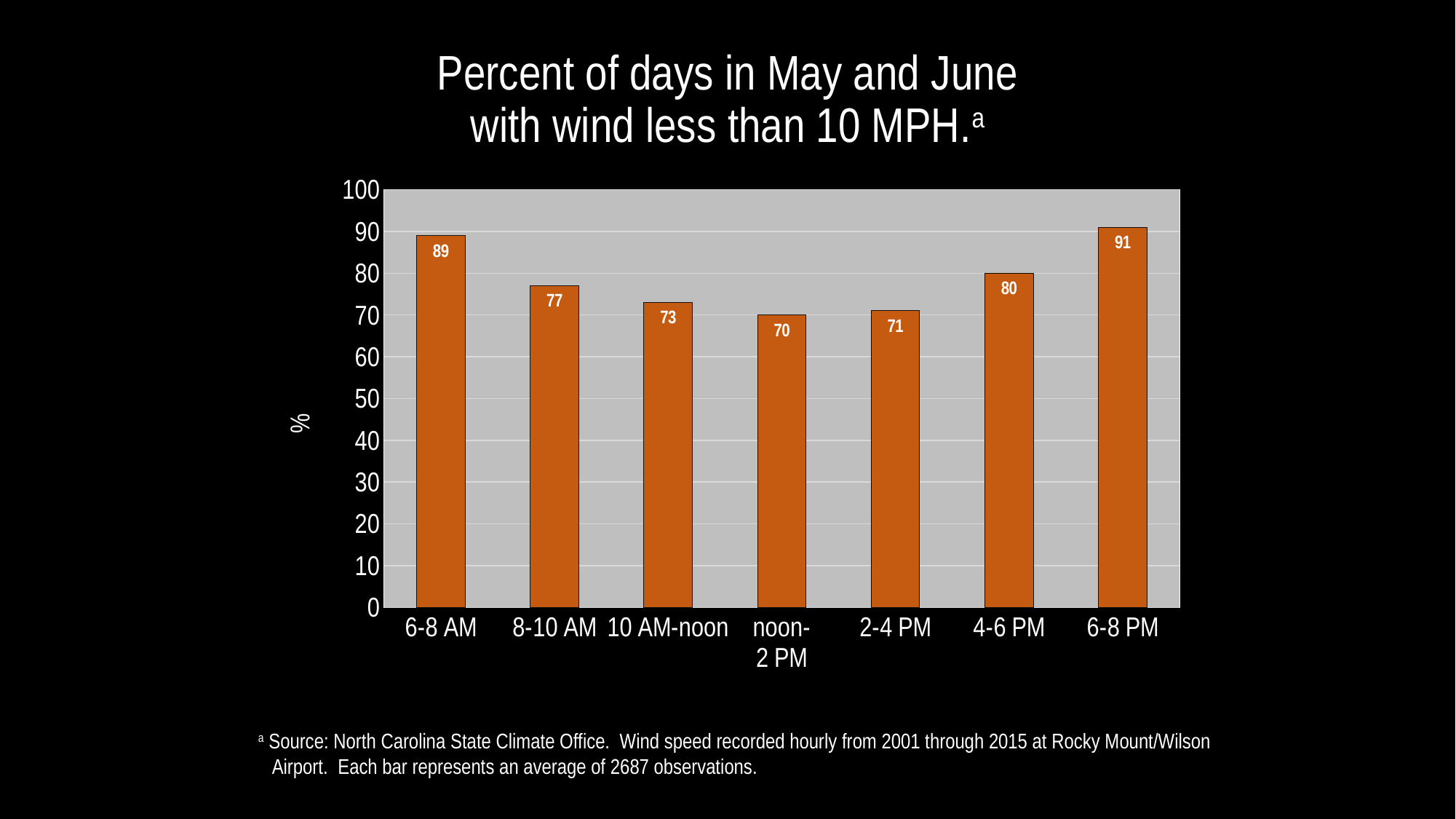
Is the value for 10 AM-noon greater or less than 80? less How many time periods are shown on the chart? 7 Which time period has the highest percent of days with wind less than 10 MPH? 6-8 PM What is the difference between the values for 6-8 PM and noon-2 PM? 21 What is the label on the vertical axis of the chart? % What is the value for noon-2 PM? 70 Which time period has the lowest percent of days with wind less than 10 MPH? noon-2 PM Which is larger, the value for 8-10 AM or the value for 4-6 PM? 4-6 PM What is the difference between the values for 6-8 AM and 8-10 AM? 12 What is the value for 4-6 PM? 80 What kind of chart is shown on the slide? bar chart What is the value for 6-8 AM? 89